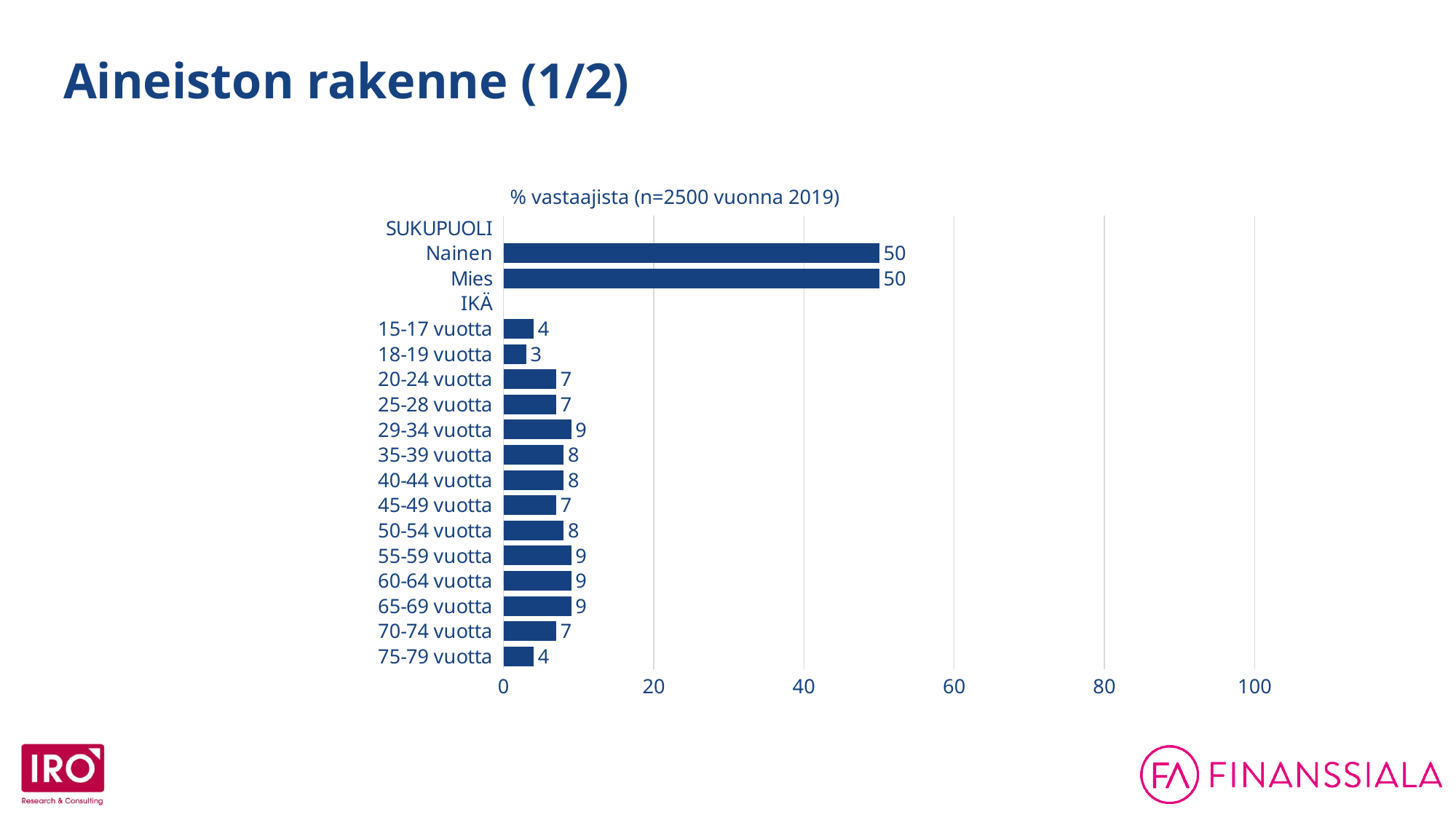
What is the value for 50-54 vuotta? 8 What is the value for Nainen? 50 What is the difference between the values for Nainen and 15-17 vuotta? 46 Is the value for Mies greater or less than 40? greater What is the value for 75-79 vuotta? 4 What is the value for 29-34 vuotta? 9 How many age groups are plotted under IKÄ? 14 Which age group has the lowest value? 18-19 vuotta Which is larger, the value for 20-24 vuotta or the value for 35-39 vuotta? 35-39 vuotta What is the difference between the values for 65-69 vuotta and 70-74 vuotta? 2 What is the value for 18-19 vuotta? 3 What kind of chart is shown on the slide? Bar chart